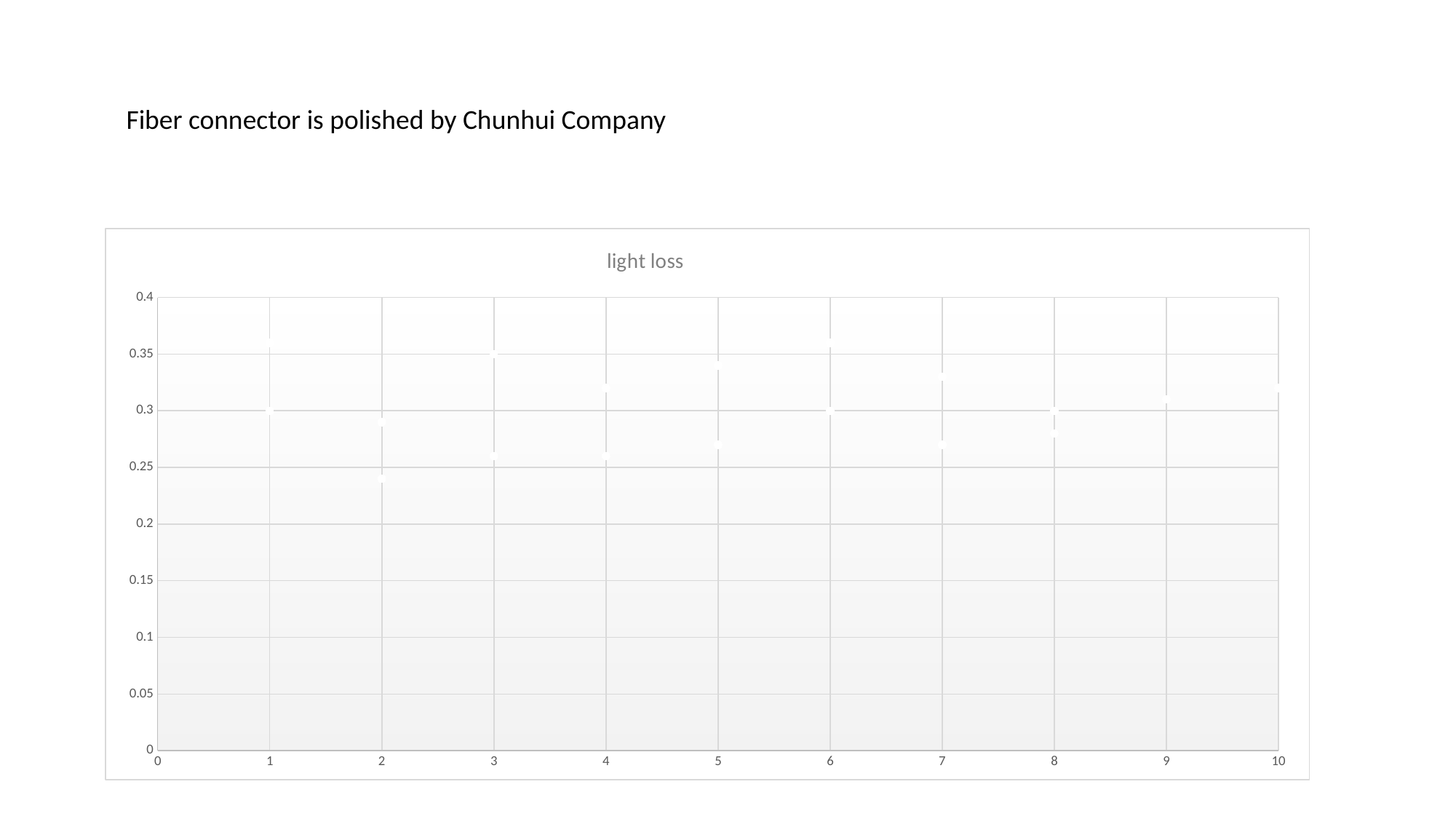
What is the title of the chart? light loss How many data points are plotted in the light loss chart? 20 Is the light loss value at x = 10 greater or less than 0.15? greater Is the light loss value at x = 1 greater or less than 0.2? greater Is the light loss value at x = 3 greater or less than 0.4? less What kind of chart is shown on the slide? scatter chart What is the highest value shown on the y axis of the light loss chart? 0.4